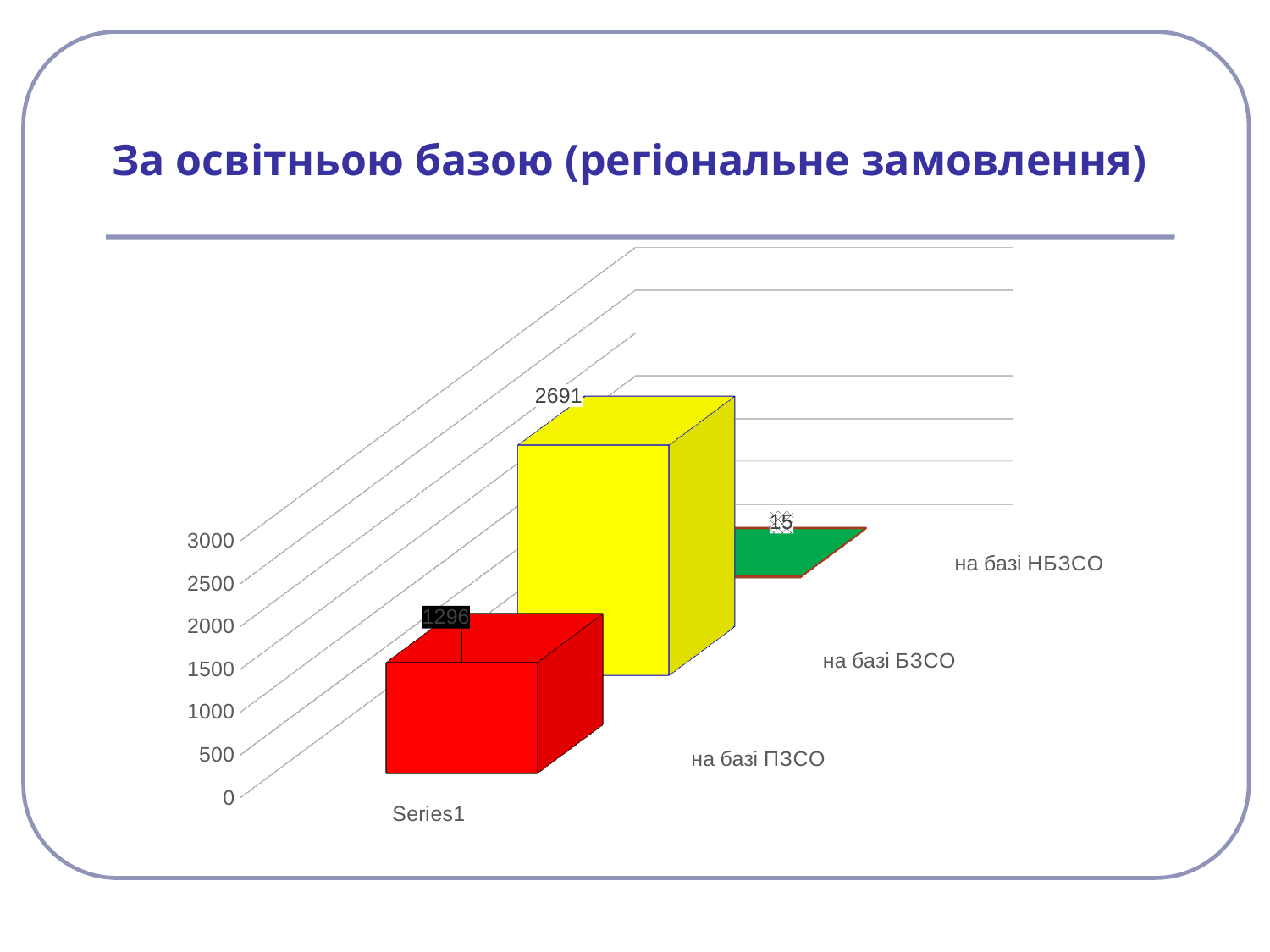
What is the difference between the values for на базі ПЗСО and на базі НБЗСО? 1281 What is the value for на базі НБЗСО? 15 Which category has the lowest value? на базі НБЗСО What is the title of the slide? За освітньою базою (регіональне замовлення) What is the difference between the values for на базі БЗСО and на базі ПЗСО? 1395 Which category has the highest value? на базі БЗСО How many categories are shown in the chart? 3 What is the value for на базі БЗСО? 2691 What is the value for на базі ПЗСО? 1296 What kind of chart is shown on the slide? bar chart Is the value for на базі БЗСО greater or less than 2500? greater Which is larger, the value for на базі ПЗСО or the value for на базі БЗСО? на базі БЗСО